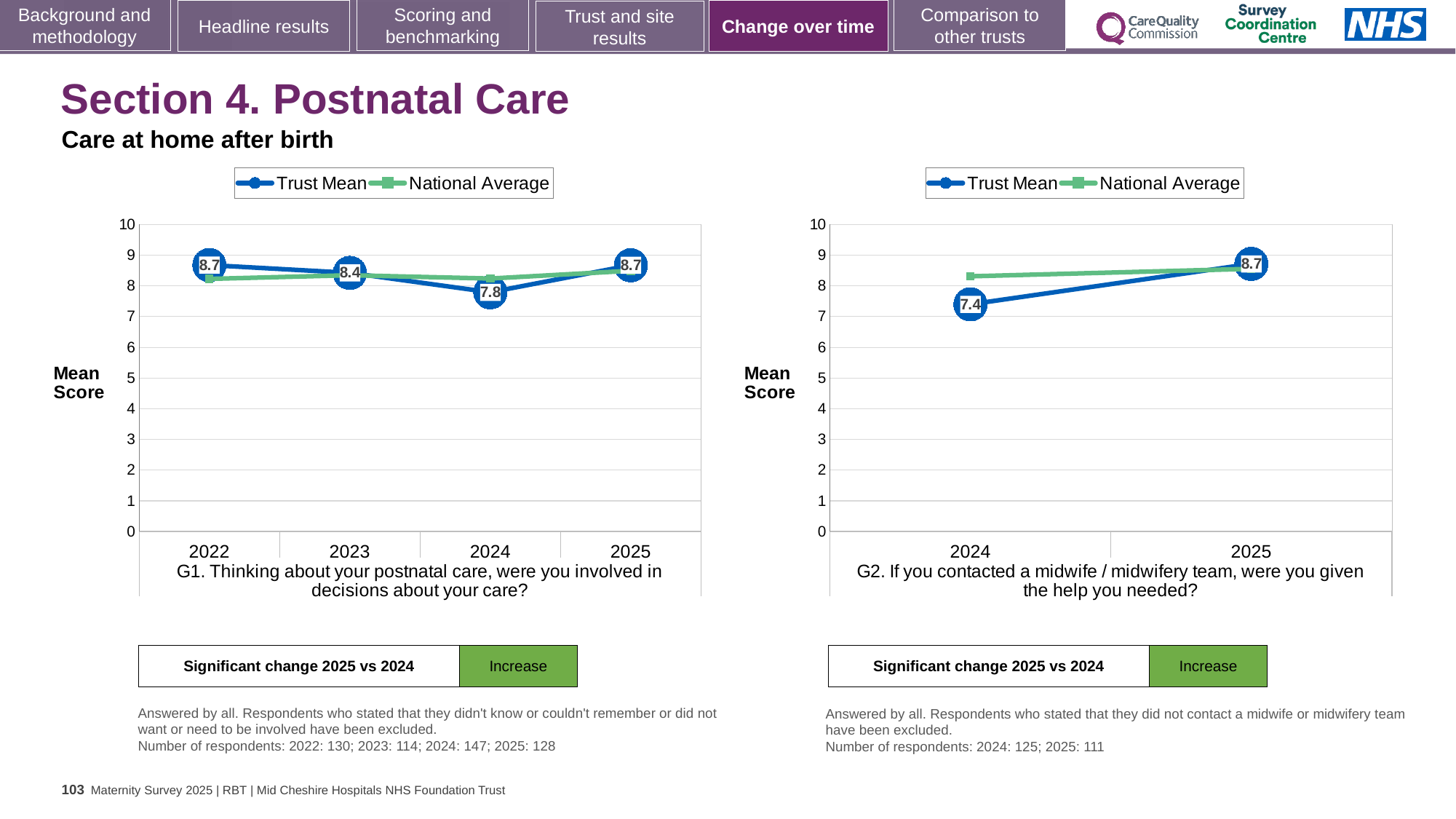
In the G2 chart (right), what is the Trust Mean for 2024? 7.4 How many years are shown on the x axis of the G1 chart (left)? 4 In the G1 chart (left), what is the Trust Mean for 2023? 8.4 In the G2 chart (right), what is the Trust Mean for 2025? 8.7 In the G2 chart (right), what is the difference between the Trust Mean for 2025 and 2024? 1.3 What kind of chart is the G2 chart (right)? line chart How many series does the legend of the G2 chart (right) list? 2 In the G1 chart (left), what is the Trust Mean for 2024? 7.8 In the G1 chart (left), is the Trust Mean for 2023 larger or smaller than the Trust Mean for 2024? larger In the G2 chart (right), is the National Average for 2024 greater or less than 8? greater In the G1 chart (left), which year has the lowest Trust Mean? 2024 In the G1 chart (left), what is the difference between the Trust Mean for 2025 and the Trust Mean for 2024? 0.9